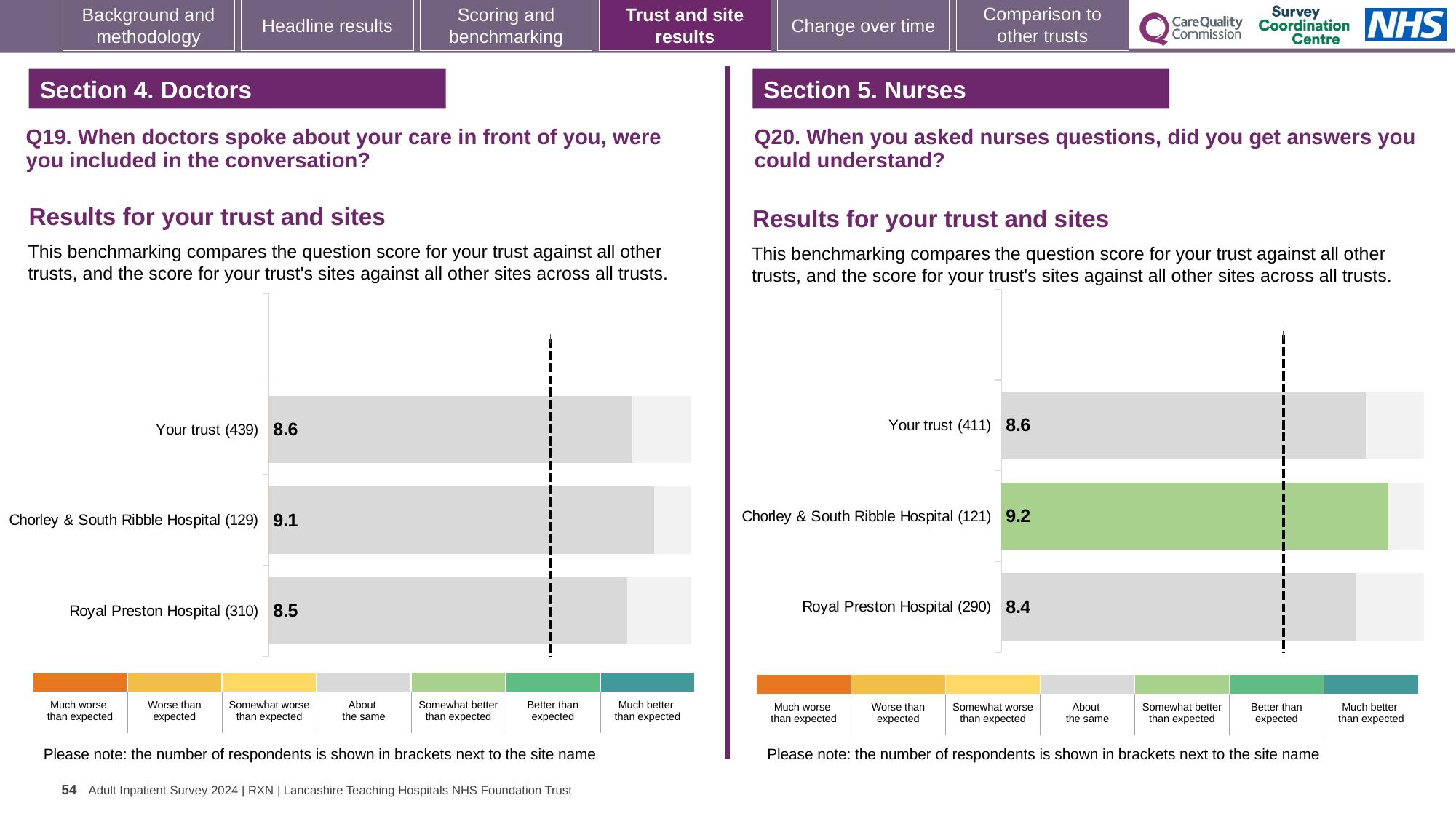
In the Q19 chart on the left, what is the score for Your trust? 8.6 In the Q20 chart on the right, what is the difference between the scores for Your trust and Royal Preston Hospital? 0.2 In the Q19 chart on the left, how many respondents are shown for Your trust? 439 In the Q20 chart on the right, how many bars are plotted? 3 In the Q19 chart on the left, what is the score for Royal Preston Hospital? 8.5 In the Q20 chart on the right, which site or trust has the lowest score? Royal Preston Hospital In the Q19 chart on the left, what is the score for Chorley & South Ribble Hospital? 9.1 In the Q19 chart on the left, what is the difference between the scores for Chorley & South Ribble Hospital and Royal Preston Hospital? 0.6 In the Q20 chart on the right, what is the score for Chorley & South Ribble Hospital? 9.2 In the Q20 chart on the right, which bar is coloured green rather than grey? Chorley & South Ribble Hospital In the Q19 chart on the left, which site or trust has the highest score? Chorley & South Ribble Hospital In the Q20 chart on the right, what is the score for Royal Preston Hospital? 8.4